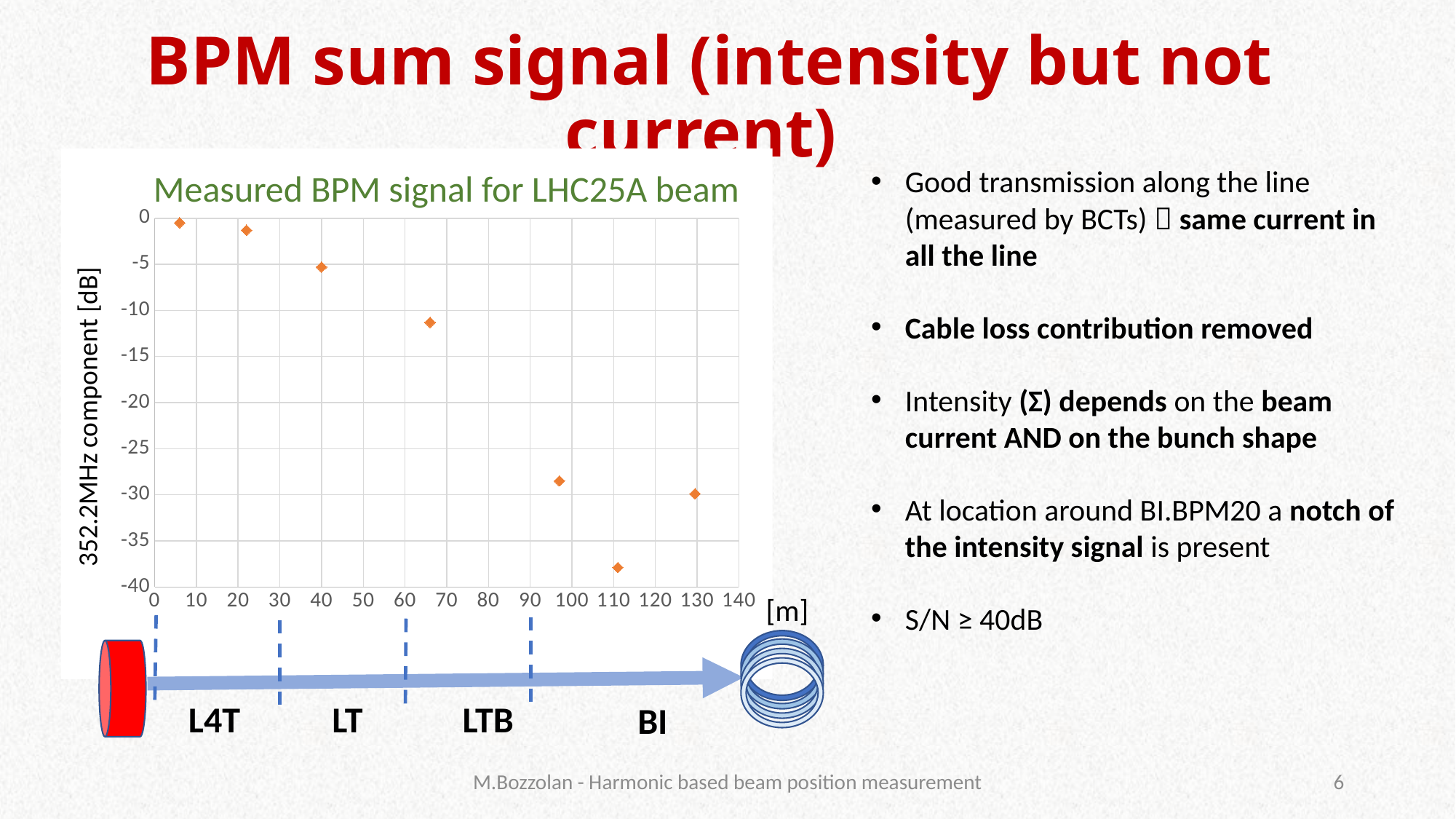
Is the value of the data point near 97 m greater or less than -25 dB? less Is the value of the data point near 130 m greater or less than -35 dB? greater Which data point has the lowest value: the one near 110 m or the one near 130 m? the one near 110 m What is the label of the vertical axis of the chart? 352.2MHz component [dB] Is the value of the data point near 110 m greater or less than -35 dB? less How many data points lie below -20 dB? 3 How many data points are plotted in the chart? 7 Which data point has the higher value: the one near 40 m or the one near 66 m? the one near 40 m What kind of chart is shown on the slide? scatter chart What is the title of the chart? Measured BPM signal for LHC25A beam